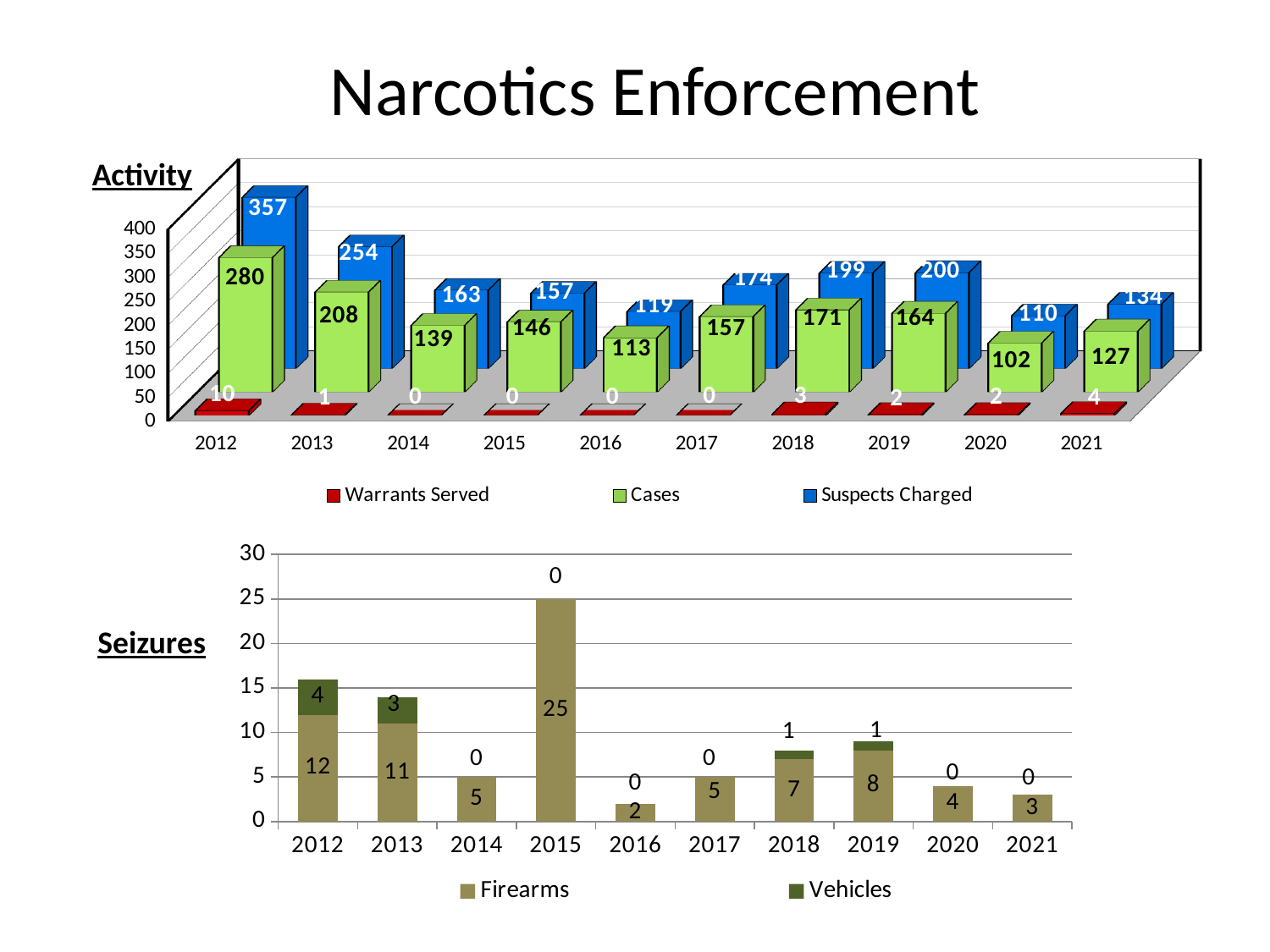
In the Activity chart, how many Cases were there in 2019? 164 In the Seizures chart, how many years are shown on the x axis? 10 In the Activity chart, which year had the lowest number of Cases? 2020 In the Activity chart, what is the difference between Suspects Charged and Cases in 2013? 46 In the Activity chart, how many Warrants Served were there in 2021? 4 What kind of chart is the Seizures chart? Stacked bar chart In the Seizures chart, what is the total of the stacked bar for 2012? 16 In the Activity chart, how many Suspects Charged were there in 2012? 357 In the Activity chart, how many series does the legend list? 3 In the Activity chart, were more Suspects Charged in 2018 or in 2021? 2018 In the Seizures chart, how many Firearms were seized in 2015? 25 In the Seizures chart, which year had the highest number of Firearms seized? 2015